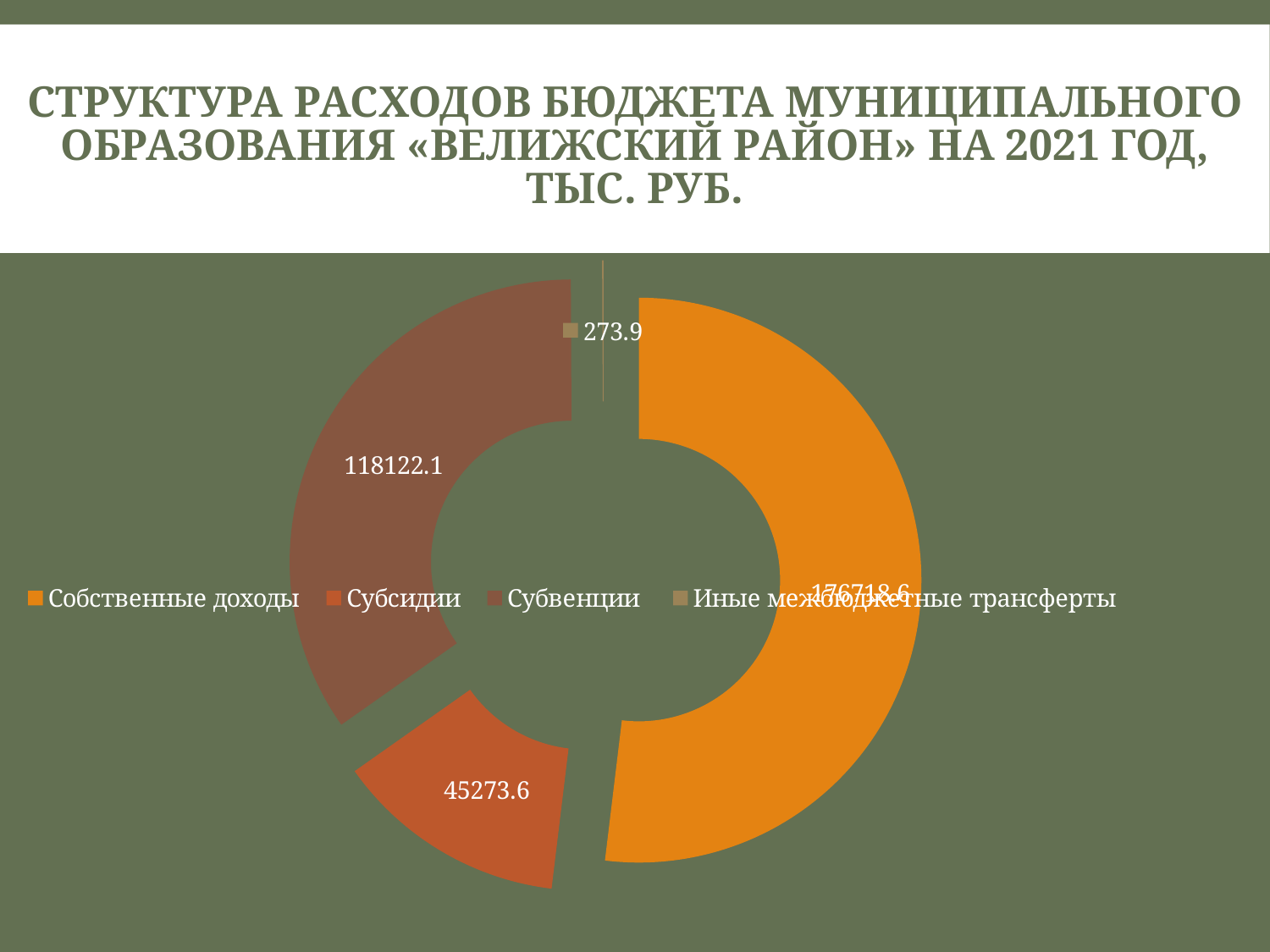
What is the difference between the values for Субсидии and Иные межбюджетные трансферты? 44999.7 What is the value for Собственные доходы? 176718.6 How many categories does the chart show? 4 What is the value for Субвенции? 118122.1 What is the value for Субсидии? 45273.6 Which is larger, Субвенции or Субсидии? Субвенции What kind of chart is shown on the slide? Doughnut chart What is the value for Иные межбюджетные трансферты? 273.9 Which category is shown in orange in the legend? Собственные доходы Which category has the largest value? Собственные доходы What is the difference between the values for Субвенции and Субсидии? 72848.5 Which category has the smallest value? Иные межбюджетные трансферты